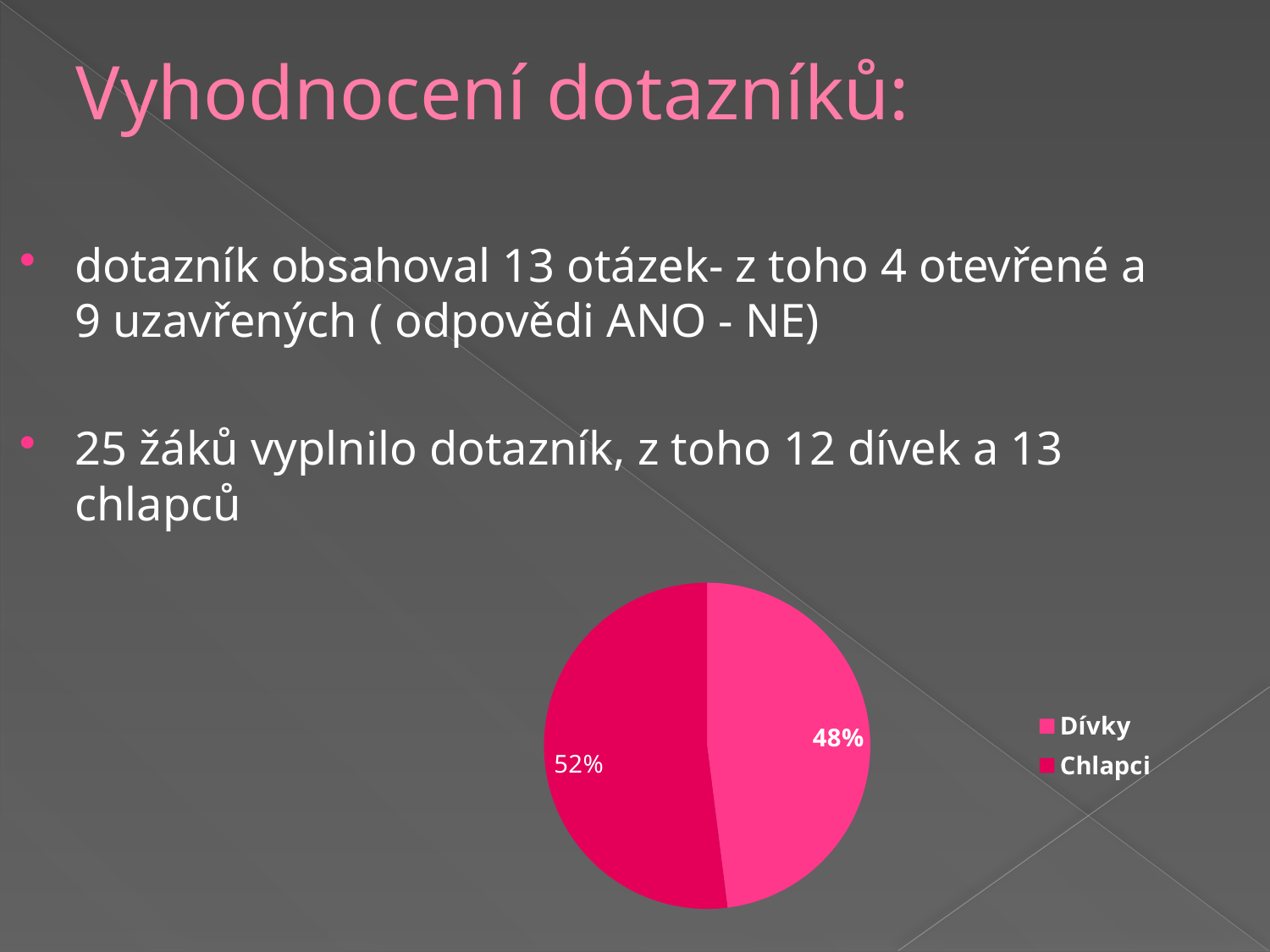
What share of the pie does Dívky represent? 48% What are the two legend entries of the pie chart? Dívky, Chlapci Which slice of the pie is the smallest? Dívky Which is larger, the Dívky slice or the Chlapci slice? Chlapci How many entries does the legend list? 2 What is the difference in percentage points between the Chlapci and Dívky slices? 4% What kind of chart is shown on the slide? pie chart Is the share for Dívky greater or less than 50%? less What share of the pie does Chlapci represent? 52% Which slice of the pie is the largest? Chlapci How many slices does the pie chart have? 2